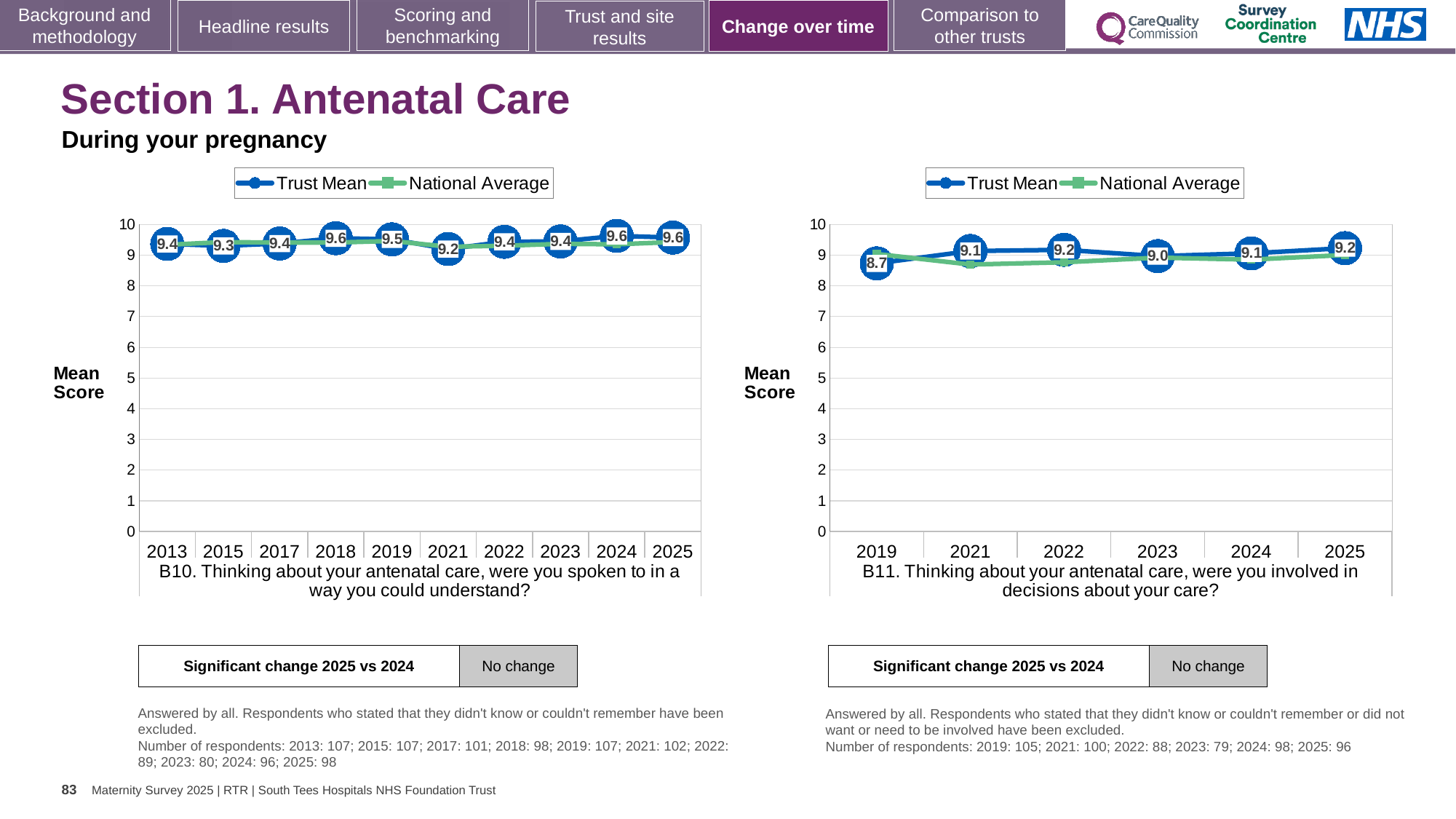
In the B10 chart, what is the Trust Mean score for 2025? 9.6 In the B11 chart, what is the Trust Mean score for 2023? 9.0 In the B11 chart, what is the Trust Mean score for 2019? 8.7 How many series does the legend of the B11 chart list? 2 How many years are plotted on the x axis of the B10 chart? 10 What kind of chart is the B11 chart? Line chart In the B10 chart, which is larger, the Trust Mean score for 2018 or for 2021? 2018 In the B11 chart, what is the difference between the Trust Mean scores for 2025 and 2019? 0.5 In the B10 chart, what is the Trust Mean score for 2021? 9.2 In the B10 chart, which year has the lowest Trust Mean score? 2021 In the B11 chart, which year has the lowest Trust Mean score? 2019 In the B11 chart, is the National Average value for 2019 greater or less than 8? greater